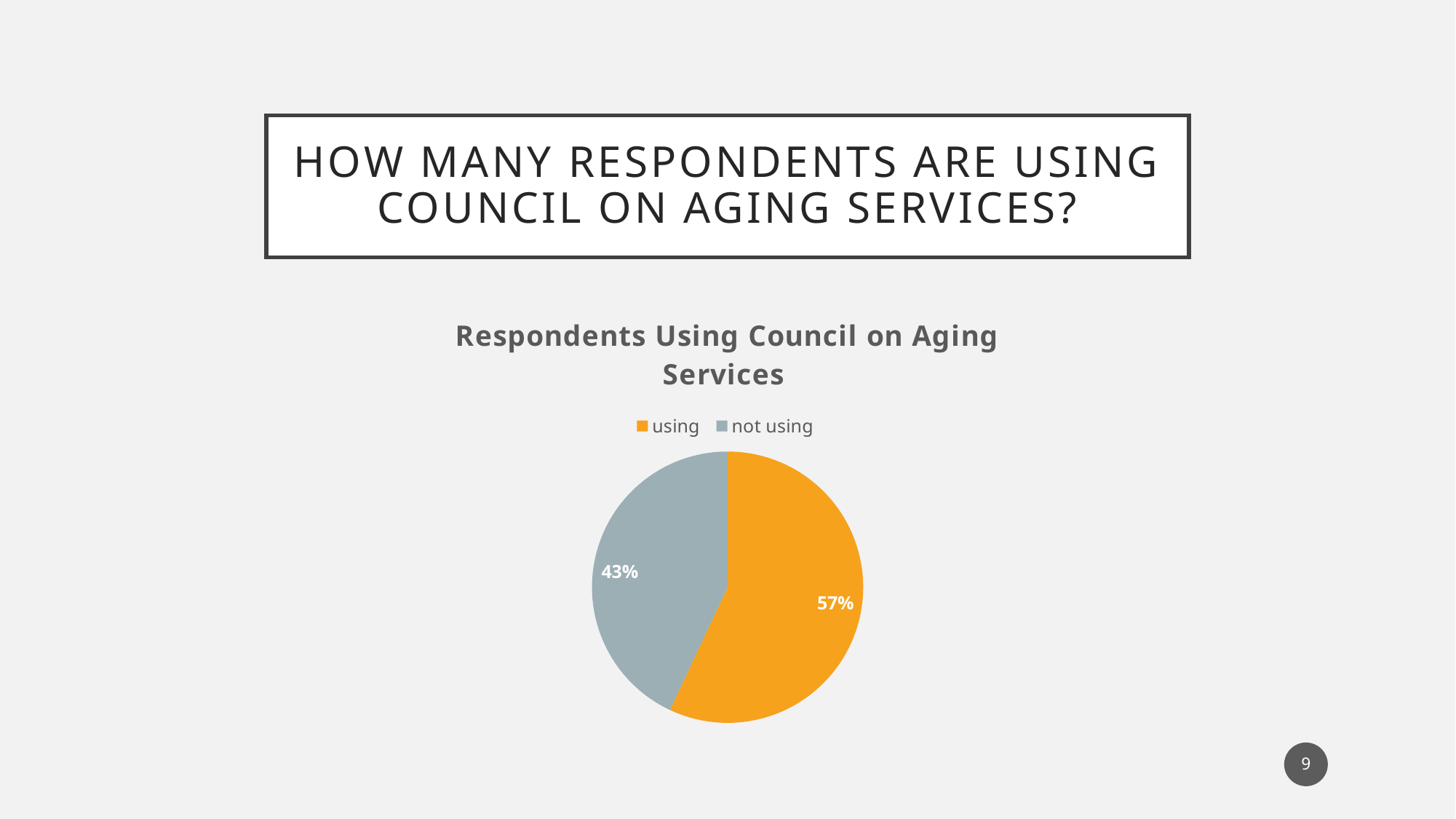
What percentage of respondents are not using Council on Aging services? 43% What share of the pie does the 'not using' slice represent? 43% How many slices does the pie chart have? 2 Which category has the largest share of the pie? using What type of chart is shown on the slide? pie chart What is the difference in percentage points between the 'using' and 'not using' slices? 14 What colour is the 'using' slice? orange Which is larger, the 'using' slice or the 'not using' slice? using What percentage of respondents are using Council on Aging services? 57% Which category has the smallest share of the pie? not using How many entries does the legend list? 2 What is the title of the chart? Respondents Using Council on Aging Services